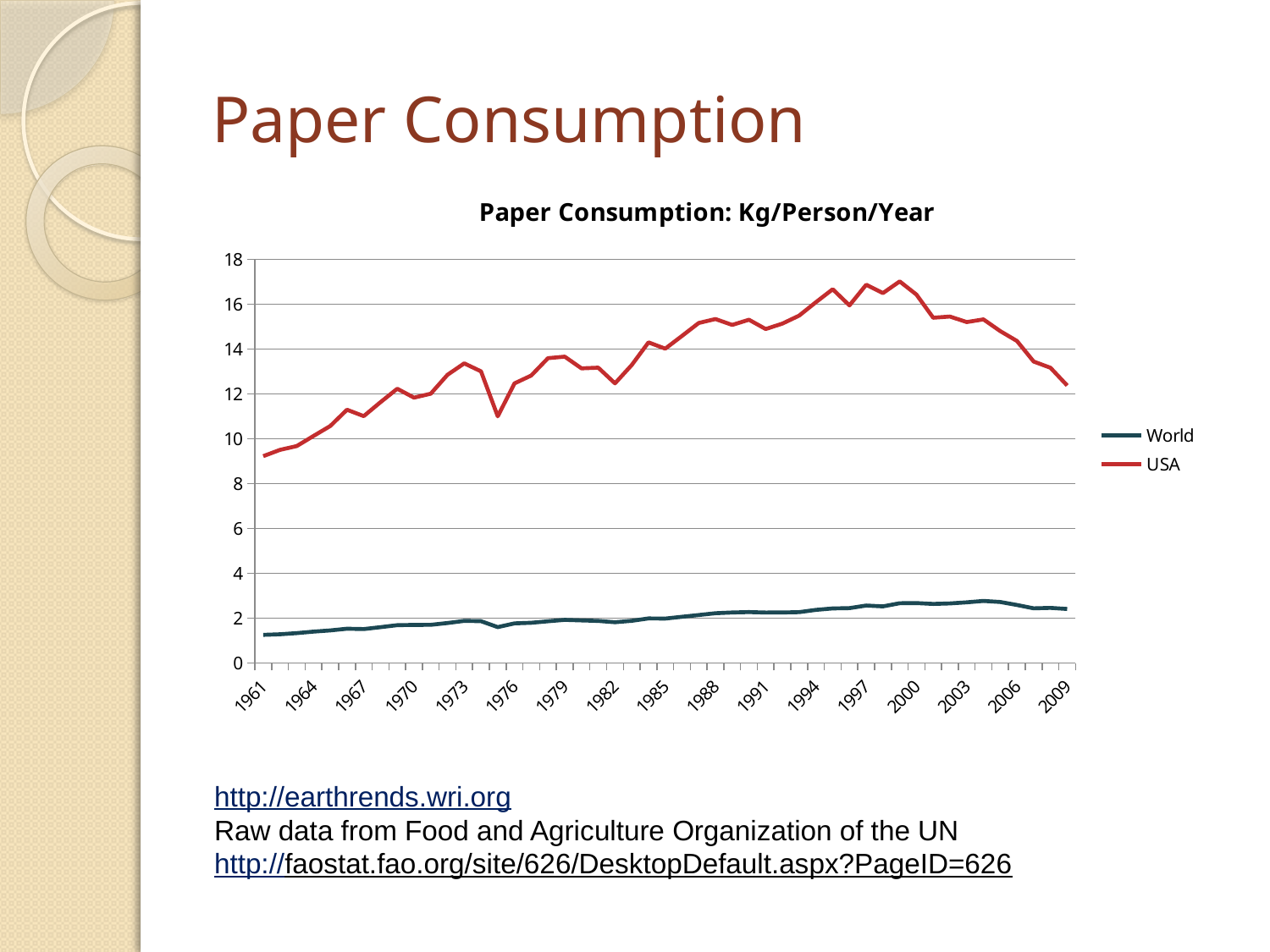
Does the USA series rise or fall from 2000 to 2009? fall Is the World value for 2009 greater or less than 4? less Is the USA value for 2009 greater or less than 10? greater What kind of chart is shown on the slide? line chart Is the USA value for 1999 greater or less than 16? greater Which series has the larger value in 2000, World or USA? USA What is the title of the chart? Paper Consumption: Kg/Person/Year In which year is the USA value lowest? 1961 How many series does the legend list? 2 Does the World series generally rise or fall from 1961 to 2009? rise Which series is drawn in red? USA